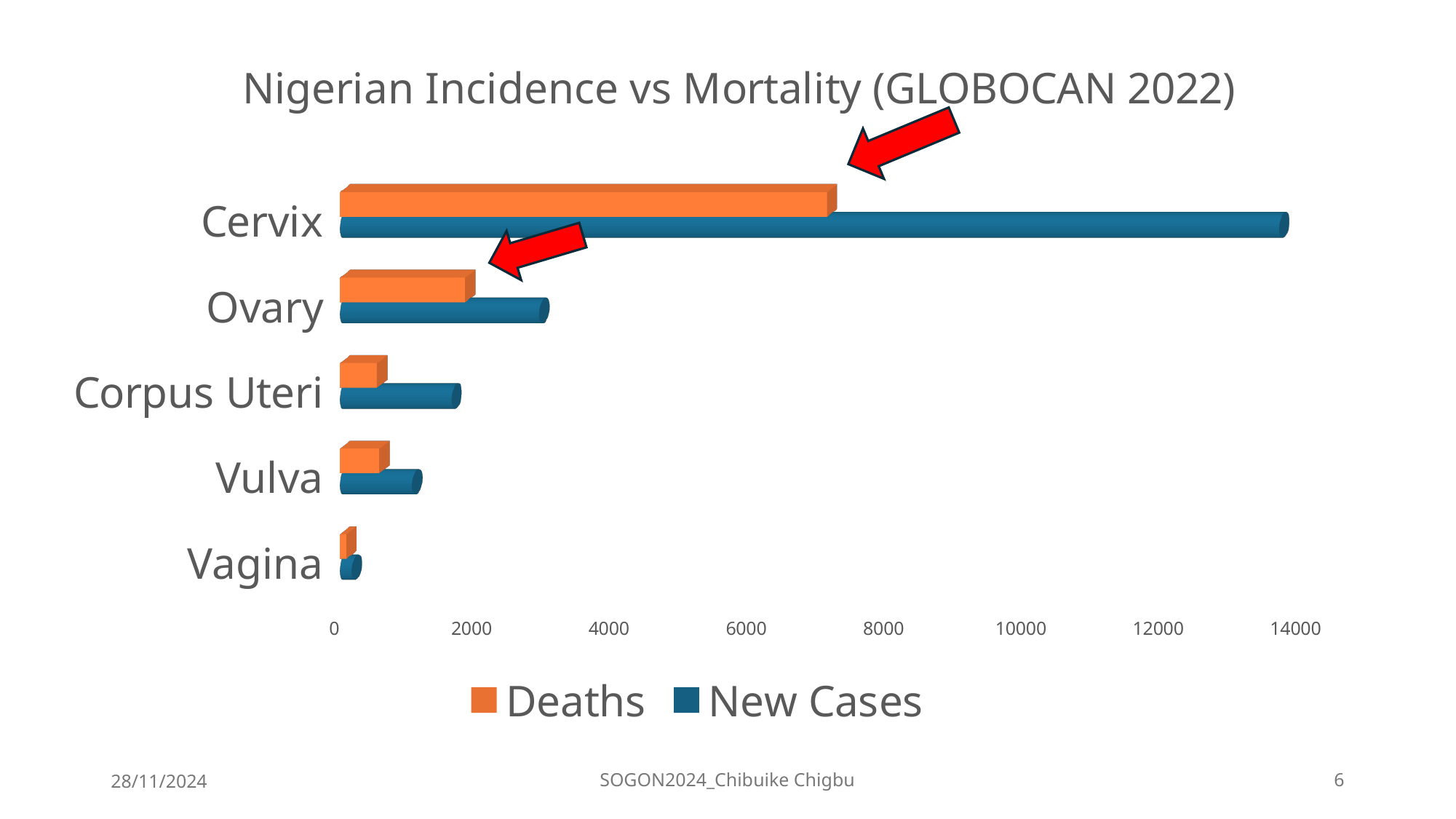
Is the value for Deaths for Cervix greater or less than 6000? greater What is the title of the chart? Nigerian Incidence vs Mortality (GLOBOCAN 2022) Which cancer site has the highest number of New Cases? Cervix How many cancer sites (categories) are plotted on the chart? 5 Is the value for New Cases for Cervix greater or less than 12000? greater Which cancer site has the lowest number of New Cases? Vagina Which cancer site has the highest number of Deaths? Cervix What kind of chart is shown on the slide? Bar chart How many series does the legend list? 2 Is the value for New Cases for Ovary greater or less than 2000? greater Which has more New Cases, Corpus Uteri or Vulva? Corpus Uteri